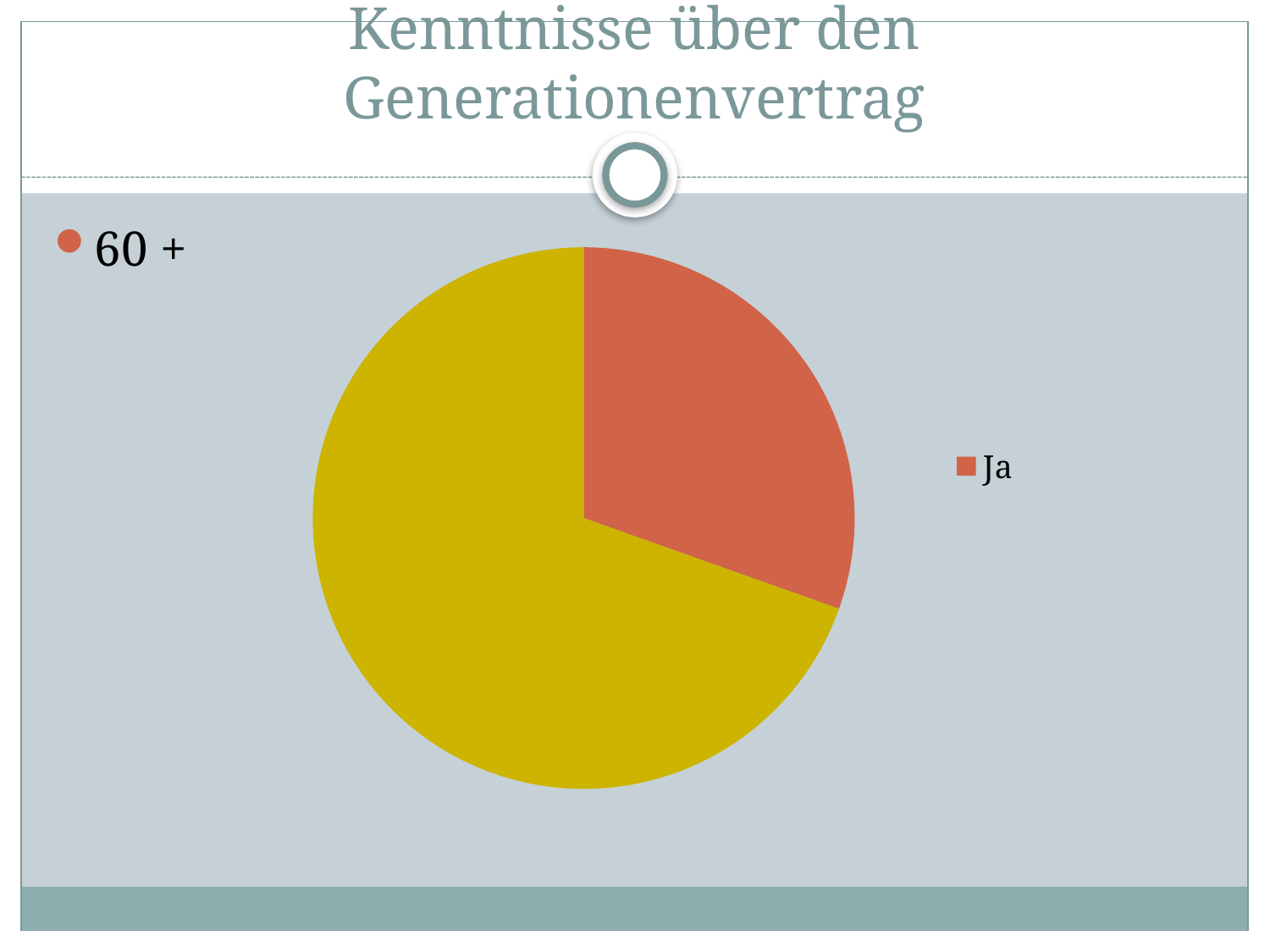
What is the only entry shown in the legend of the pie chart? Ja What kind of chart is shown on the slide? pie chart What is the title of the slide containing the pie chart? Kenntnisse über den Generationenvertrag Is the "Ja" slice the largest or the smallest slice of the pie chart? the smallest How many entries does the legend of the pie chart list? 1 Does the "Ja" slice cover more or less than half of the pie chart? less How many slices does the pie chart have? 2 Which slice is larger in the pie chart, the "Ja" slice or the yellow slice? the yellow slice